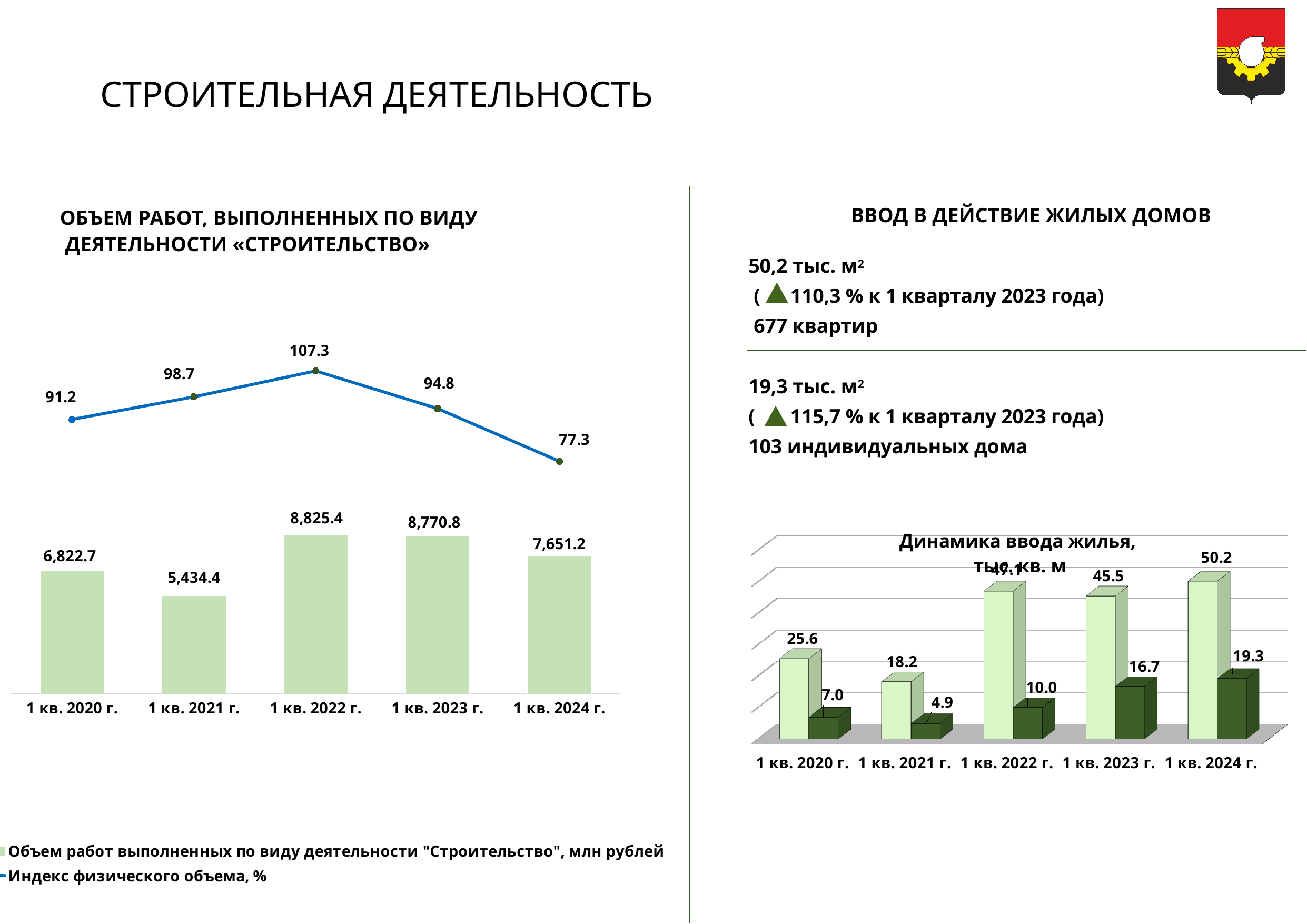
On the left chart (Объем работ, выполненных по виду деятельности «Строительство»), which period has the lowest bar value? 1 кв. 2021 г. On the right chart (Динамика ввода жилья, тыс. кв. м), what is the value of the light green bar for 1 кв. 2024 г.? 50.2 On the right chart (Динамика ввода жилья, тыс. кв. м), how many periods are shown on the x axis? 5 On the left chart (Объем работ, выполненных по виду деятельности «Строительство»), what is the value of the line (Индекс физического объема, %) for 1 кв. 2024 г.? 77.3 On the left chart (Объем работ, выполненных по виду деятельности «Строительство»), which period has the highest value of the line (Индекс физического объема, %)? 1 кв. 2022 г. On the right chart (Динамика ввода жилья, тыс. кв. м), what is the value of the dark green bar for 1 кв. 2021 г.? 4.9 On the right chart (Динамика ввода жилья, тыс. кв. м), which period has the lowest dark green bar value? 1 кв. 2021 г. On the left chart (Объем работ, выполненных по виду деятельности «Строительство»), how many series does the legend list? 2 On the left chart (Объем работ, выполненных по виду деятельности «Строительство»), what is the value of the bar for 1 кв. 2022 г.? 8,825.4 On the right chart (Динамика ввода жилья, тыс. кв. м), is the dark green bar for 1 кв. 2023 г. larger or smaller than the dark green bar for 1 кв. 2024 г.? smaller On the left chart (Объем работ, выполненных по виду деятельности «Строительство»), what is the difference between the bar values for 1 кв. 2022 г. and 1 кв. 2023 г.? 54.6 On the left chart (Объем работ, выполненных по виду деятельности «Строительство»), does the line (Индекс физического объема, %) rise or fall from 1 кв. 2022 г. to 1 кв. 2024 г.? fall